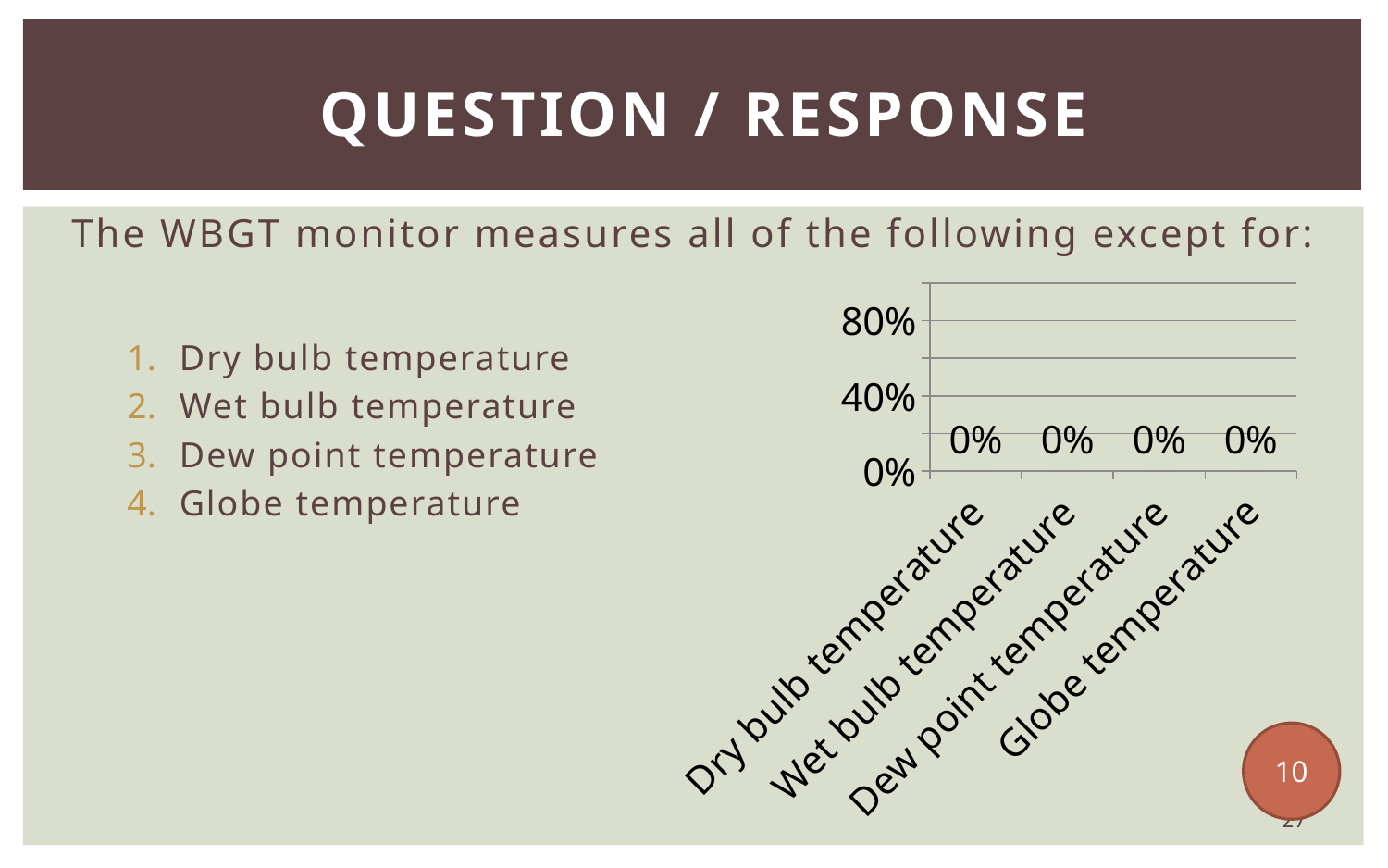
What kind of chart is shown on the slide? bar chart What is the label of the first category on the x axis of the chart? Dry bulb temperature What is the value shown for Dry bulb temperature in the chart? 0% What is the value shown for Dew point temperature in the chart? 0% Is the value for Dry bulb temperature greater or less than 80%? less What is the value shown for Wet bulb temperature in the chart? 0% What is the highest value labelled on the vertical axis of the chart? 80% How many categories are shown on the x axis of the chart? 4 Is the value for Globe temperature greater or less than 40%? less Do the values rise, fall, or stay flat across the categories on the x axis? stay flat What is the difference between the values for Dry bulb temperature and Globe temperature? 0% What is the value shown for Globe temperature in the chart? 0%